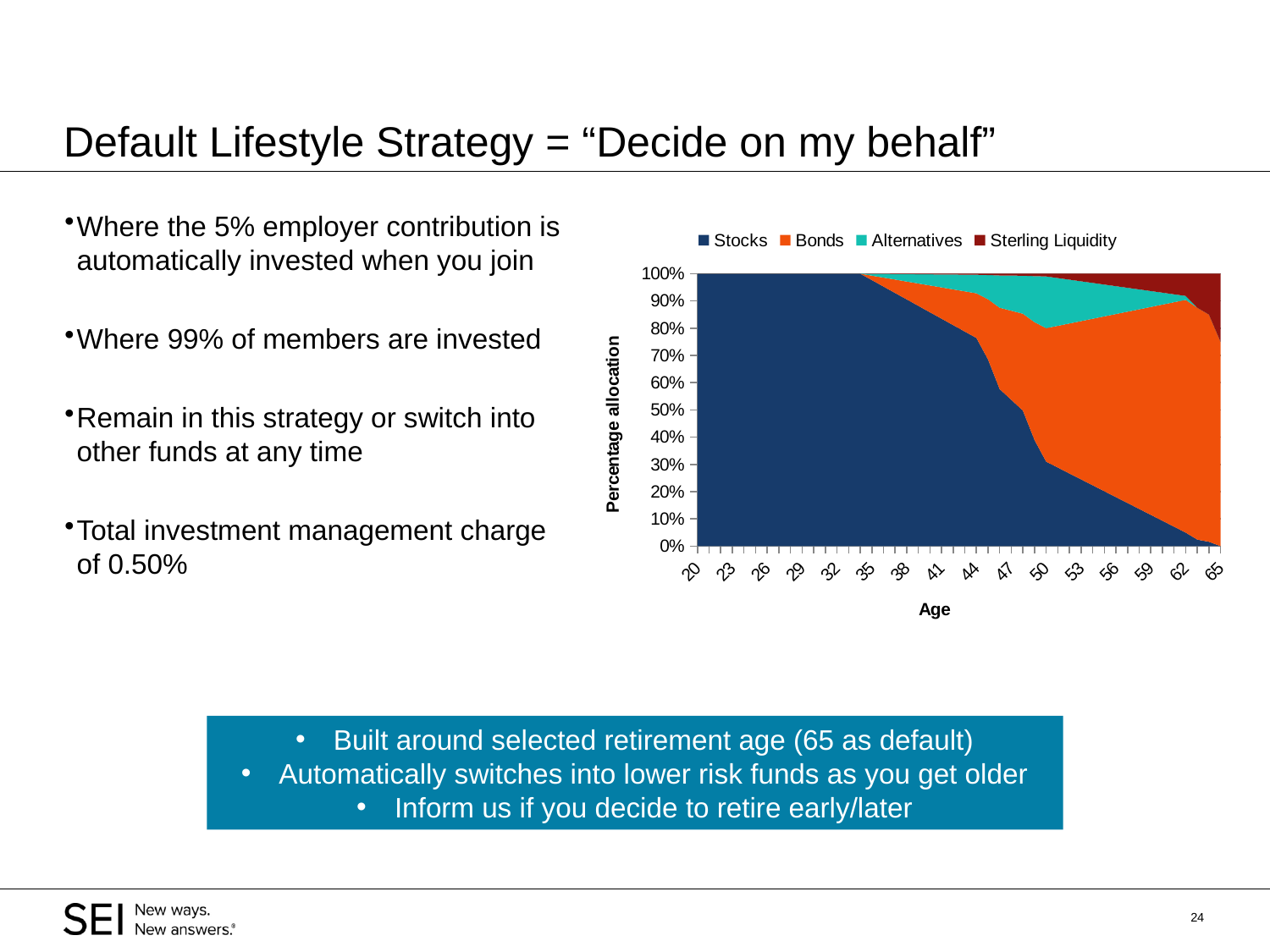
Does the allocation to Bonds rise or fall as age increases along the x axis? Rise Which series has the largest allocation at age 20? Stocks Is the allocation to Stocks at age 44 greater or less than 60%? greater How many age labels are shown along the x axis of the chart? 16 Which series has the largest allocation at age 65? Bonds What is the label of the chart's vertical axis? Percentage allocation What are the series listed in the chart's legend? Stocks, Bonds, Alternatives, Sterling Liquidity What kind of chart is shown on the slide? Stacked area chart Is the allocation to Stocks at age 62 greater or less than 10%? less Does the allocation to Stocks rise or fall as age increases along the x axis? Fall Is the allocation to Stocks at age 20 greater or less than 90%? greater How many series does the chart's legend list? 4